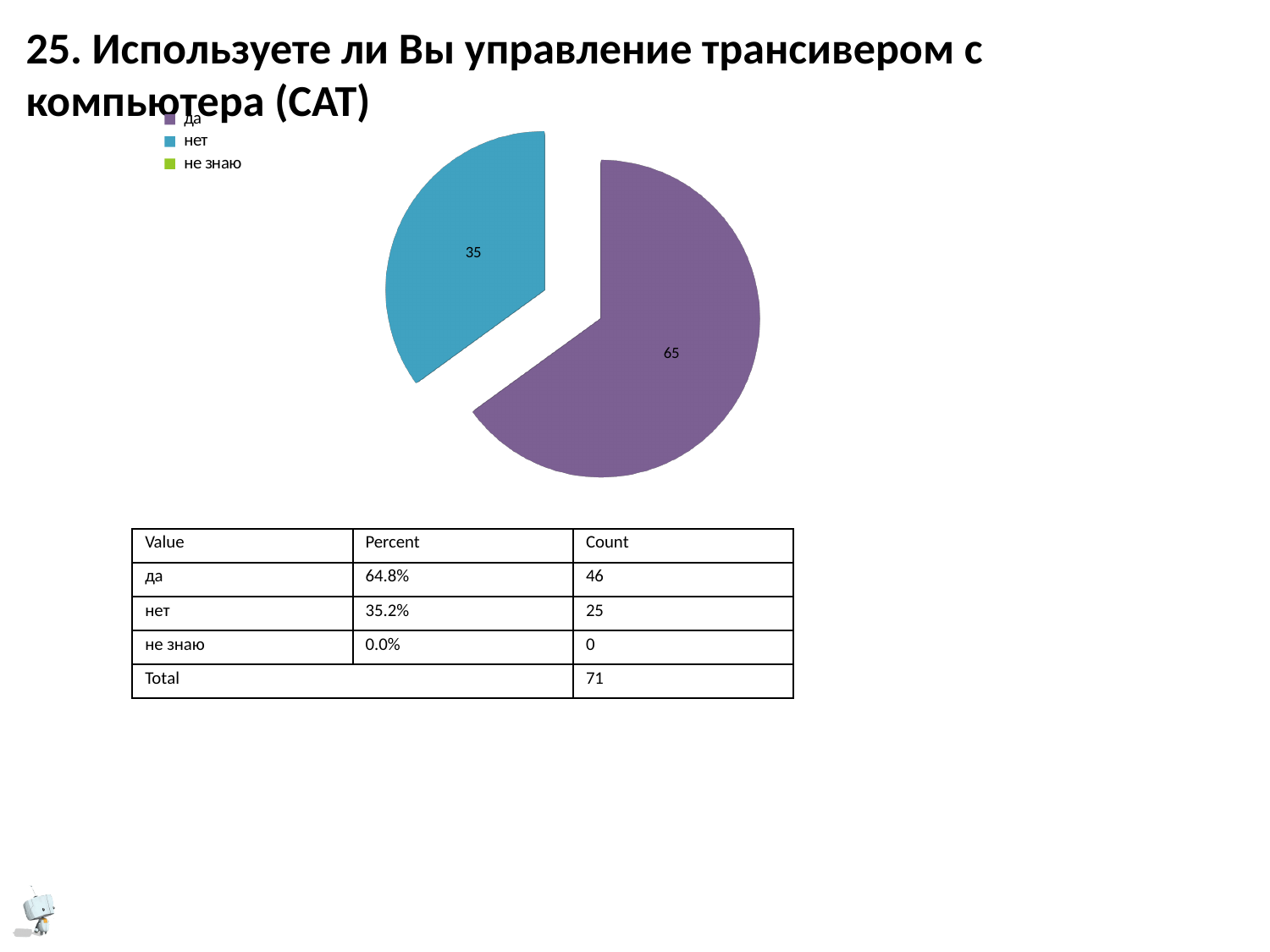
What value is printed on the pie slice for "да"? 65 What colour is the slice for "нет"? blue How many slices are visible in the pie? 2 Which category has the largest slice of the pie? да How many entries does the legend list? 3 Which of the two visible slices is smaller, "да" or "нет"? нет What value is printed on the pie slice for "нет"? 35 Is the slice for "да" larger or smaller than the slice for "нет"? larger What colour is the slice for "да"? purple What kind of chart is shown on the slide? pie chart Is the value printed on the "нет" slice greater or less than 50? less What is the difference between the values printed on the "да" and "нет" slices? 30